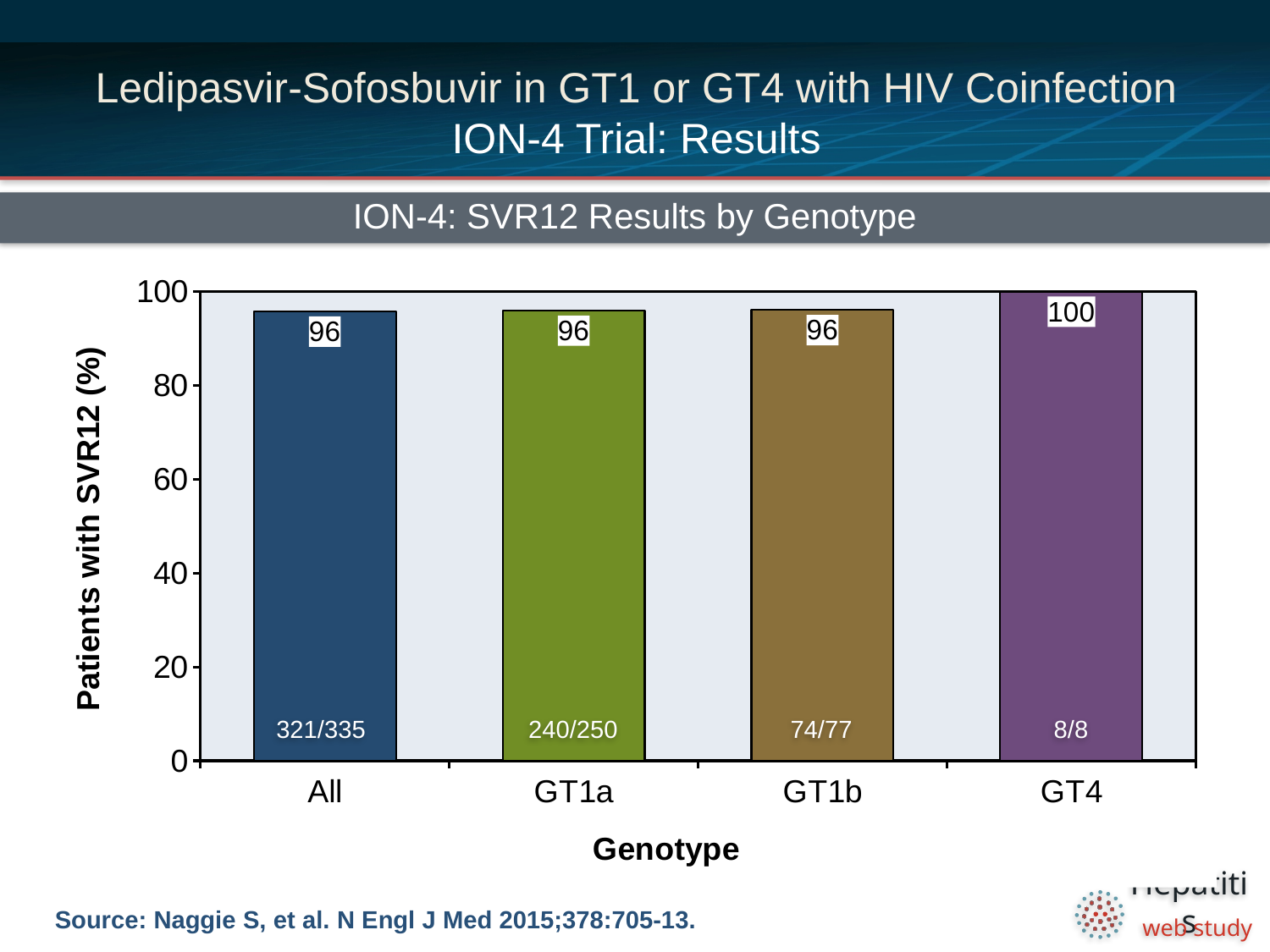
What is the SVR12 rate for the GT1a group? 96 What kind of chart is shown on the slide? bar chart Which genotype group has the highest SVR12 rate? GT4 What is the title of the chart? ION-4: SVR12 Results by Genotype What is the SVR12 rate for the All group? 96 What is the label of the y axis? Patients with SVR12 (%) What fraction of patients is shown inside the GT1b bar? 74/77 Is the SVR12 rate for GT1a greater or less than 80? greater How many genotype categories are shown on the x axis? 4 What fraction of patients is shown inside the All bar? 321/335 What is the SVR12 rate for the GT4 group? 100 What is the difference in SVR12 rate between GT4 and GT1b? 4